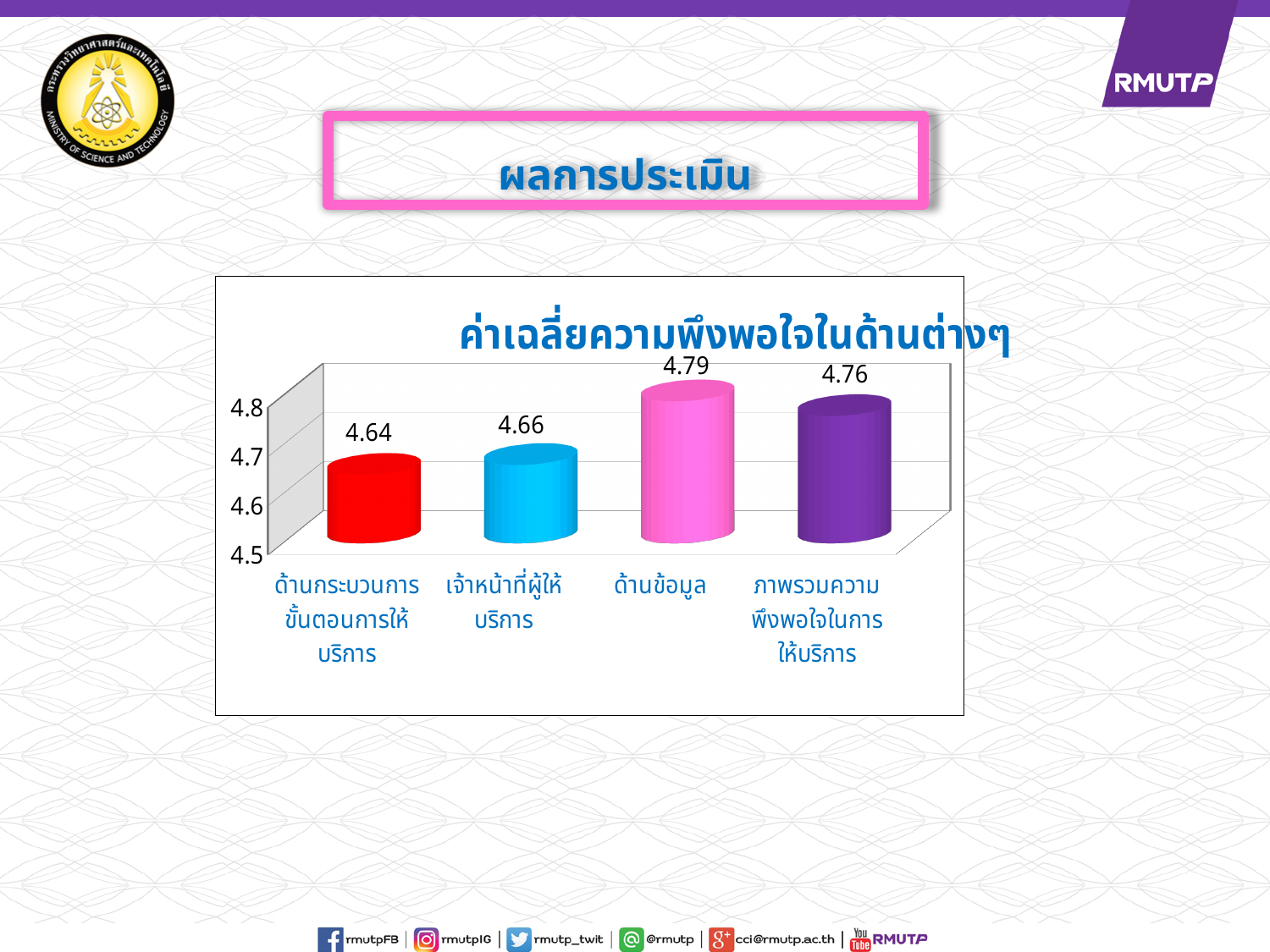
What kind of chart is shown on the slide? Bar chart What is the difference between the values for ภาพรวมความพึงพอใจในการให้บริการ and เจ้าหน้าที่ผู้ให้บริการ? 0.10 What is the value for ด้านข้อมูล? 4.79 What is the value for เจ้าหน้าที่ผู้ให้บริการ? 4.66 How many categories are shown in the chart? 4 Which is larger, the value for ด้านข้อมูล or the value for ภาพรวมความพึงพอใจในการให้บริการ? ด้านข้อมูล What is the value for ด้านกระบวนการขั้นตอนการให้บริการ? 4.64 What is the value for ภาพรวมความพึงพอใจในการให้บริการ? 4.76 What is the title of the chart? ค่าเฉลี่ยความพึงพอใจในด้านต่างๆ Which category has the lowest value? ด้านกระบวนการขั้นตอนการให้บริการ What is the difference between the values for ด้านข้อมูล and ด้านกระบวนการขั้นตอนการให้บริการ? 0.15 Which category has the highest value? ด้านข้อมูล